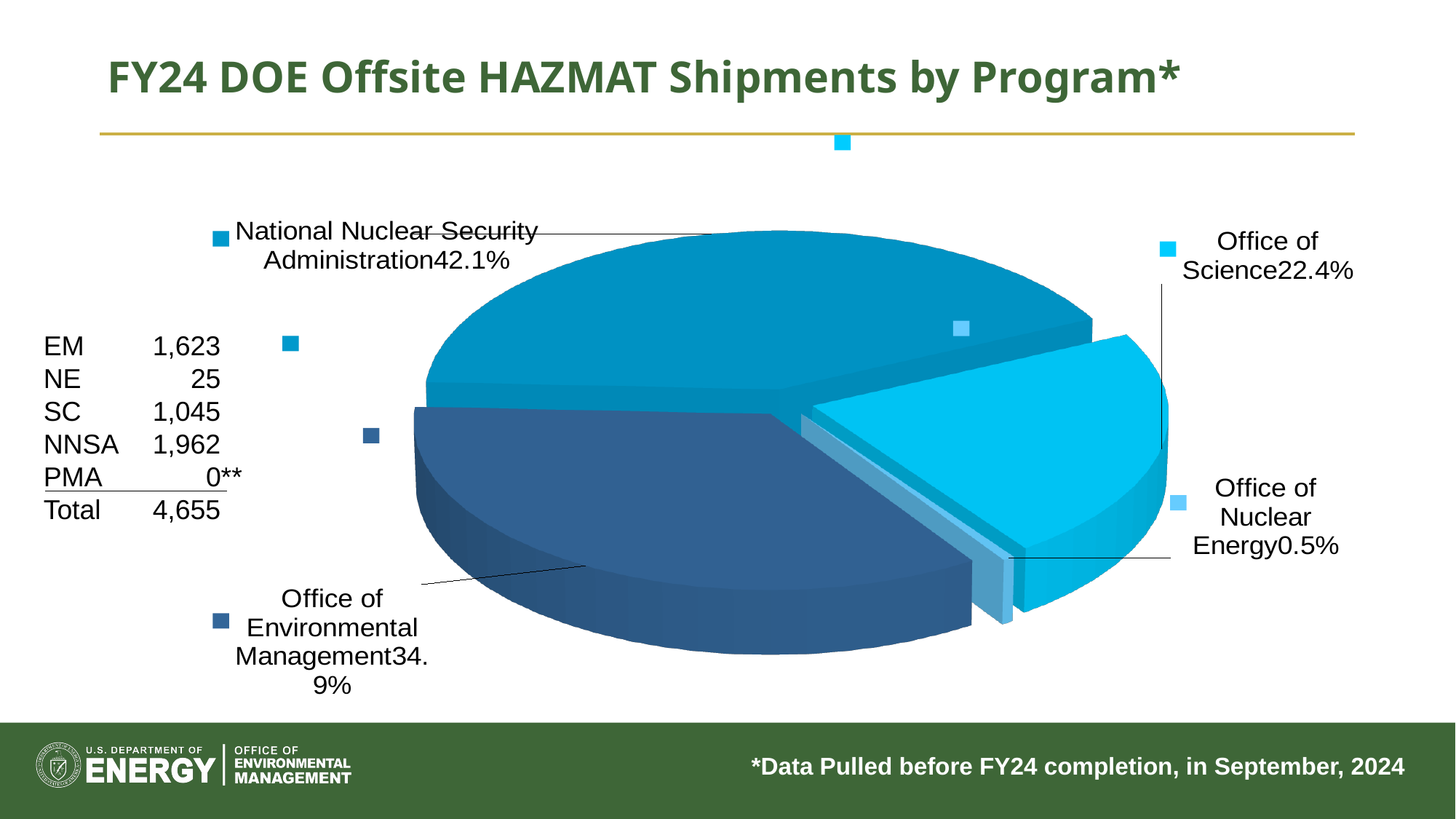
Which slice is pulled out (exploded) from the rest of the pie? Office of Science What share of the pie does the Office of Science hold? 22.4% By how many percentage points does the National Nuclear Security Administration's share exceed the Office of Environmental Management's share? 7.2 What share of the pie does the National Nuclear Security Administration hold? 42.1% What is the title of the slide's chart? FY24 DOE Offsite HAZMAT Shipments by Program* Which has a larger share, the Office of Science or the Office of Environmental Management? Office of Environmental Management What share of the pie does the Office of Environmental Management hold? 34.9% Which program has the smallest slice of the pie? Office of Nuclear Energy What kind of chart is shown on the slide? pie chart How many labelled slices does the pie chart have? 4 Which program has the largest slice of the pie? National Nuclear Security Administration